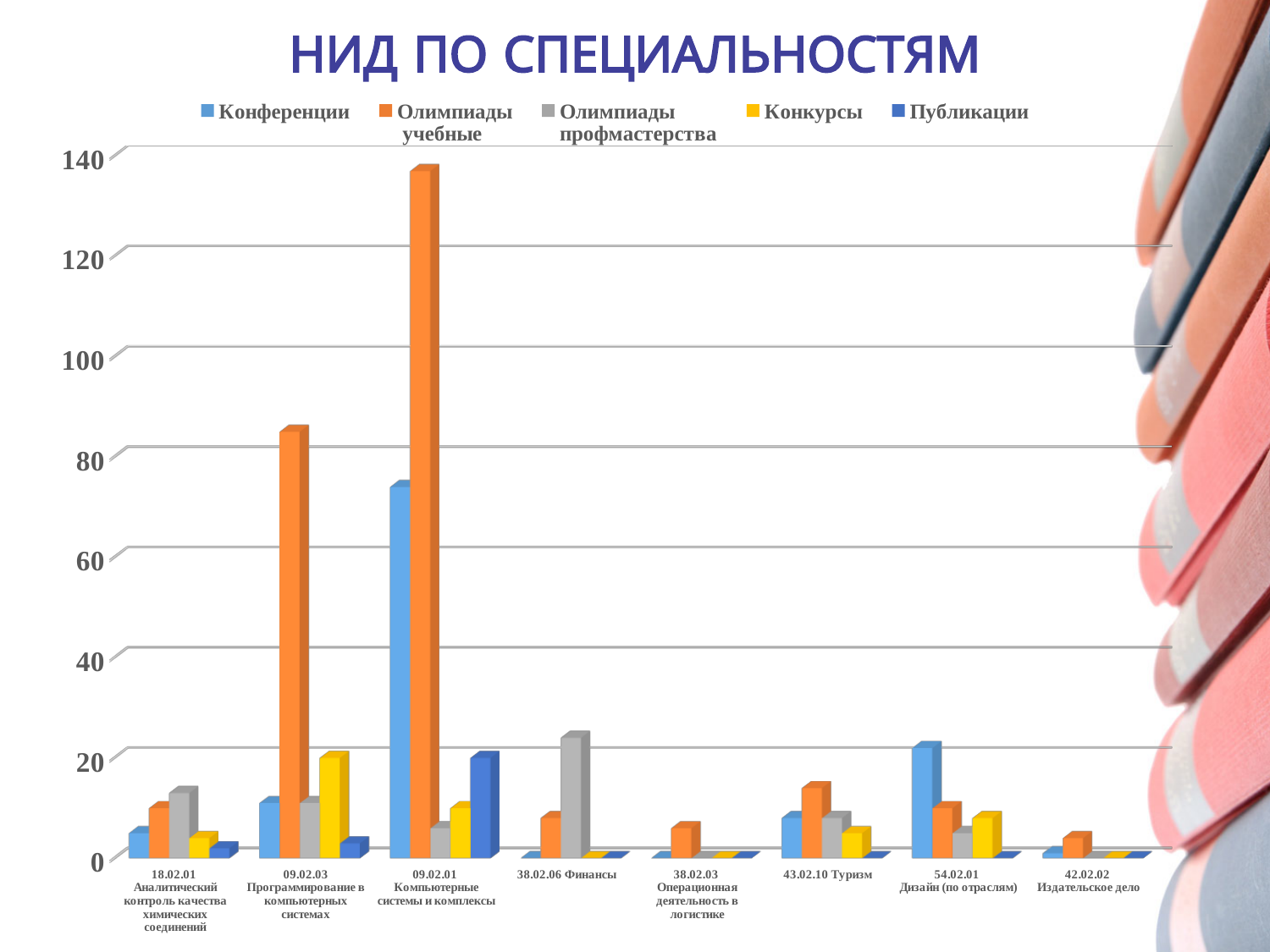
How many specialty categories are shown along the x axis? 8 Which is larger in 09.02.03 Программирование в компьютерных системах: Олимпиады учебные or Конкурсы? Олимпиады учебные Is the value for Олимпиады учебные in 09.02.01 Компьютерные системы и комплексы greater or less than 120? greater Which category has the highest value for Конференции? 09.02.01 Компьютерные системы и комплексы What is the title of the chart? НИД ПО СПЕЦИАЛЬНОСТЯМ How many series does the legend list? 5 Is the value for Конференции in 09.02.01 Компьютерные системы и комплексы greater or less than 60? greater What kind of chart is shown on the slide? bar chart Is the value for Олимпиады профмастерства in 38.02.06 Финансы greater or less than 40? less Which category has the highest value for Олимпиады учебные? 09.02.01 Компьютерные системы и комплексы Which is larger in 54.02.01 Дизайн (по отраслям): Конференции or Олимпиады учебные? Конференции